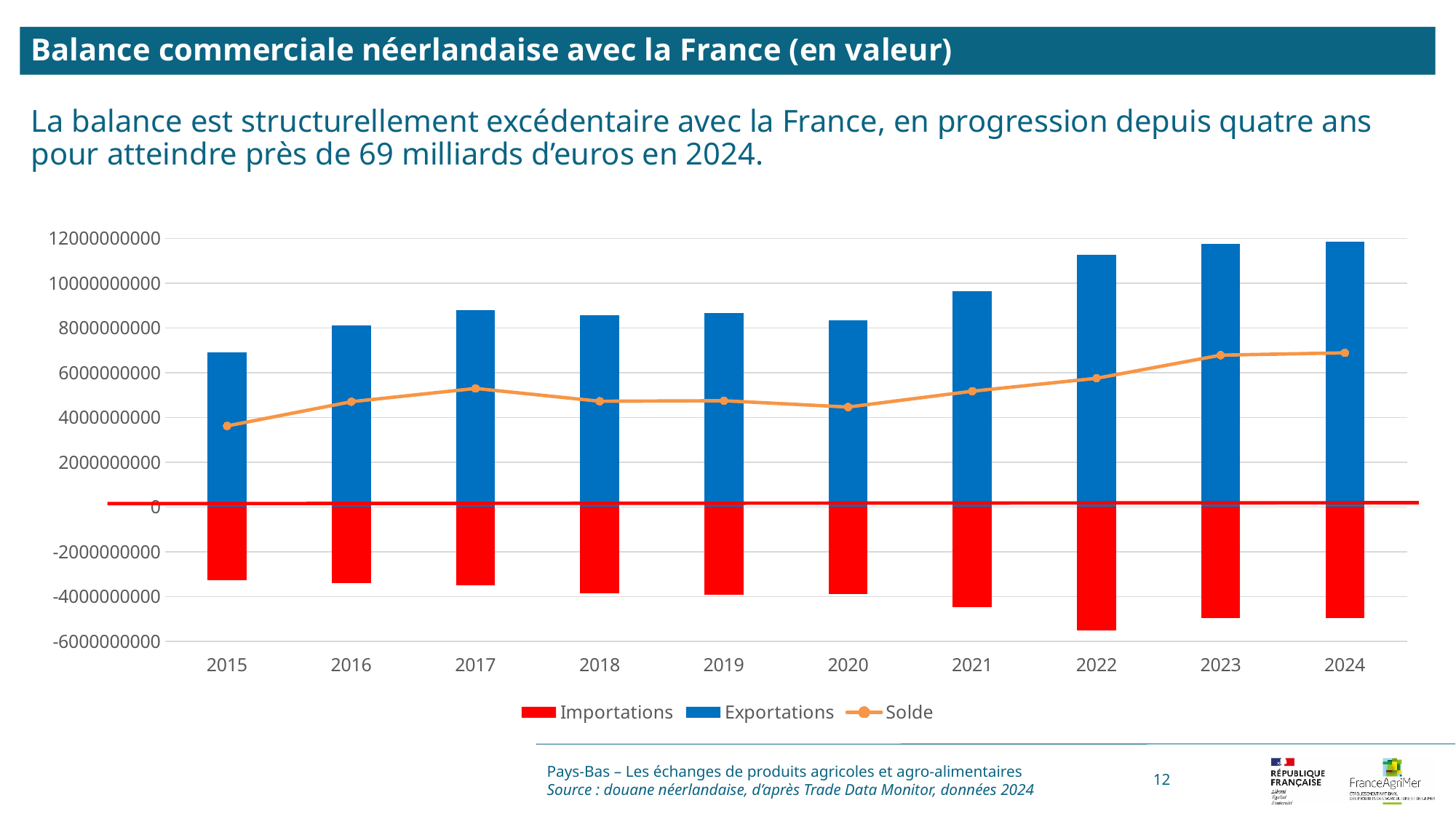
Which year has the larger Exportations value, 2020 or 2021? 2021 Which year has the longest Importations bar (largest negative value)? 2022 Is the Solde value for 2024 greater or less than 6000000000? greater Which series is drawn as an orange line in the chart? Solde Which year has the lowest Exportations value? 2015 What is the title of the slide containing the chart? Balance commerciale néerlandaise avec la France (en valeur) Is the Exportations value for 2024 greater or less than 10000000000? greater How many years are shown on the x axis of the chart? 10 Which year has the lowest Solde value? 2015 How many series does the chart legend list? 3 Is the Exportations value for 2015 greater or less than 8000000000? less What type of chart is shown on the slide? Bar chart with a line